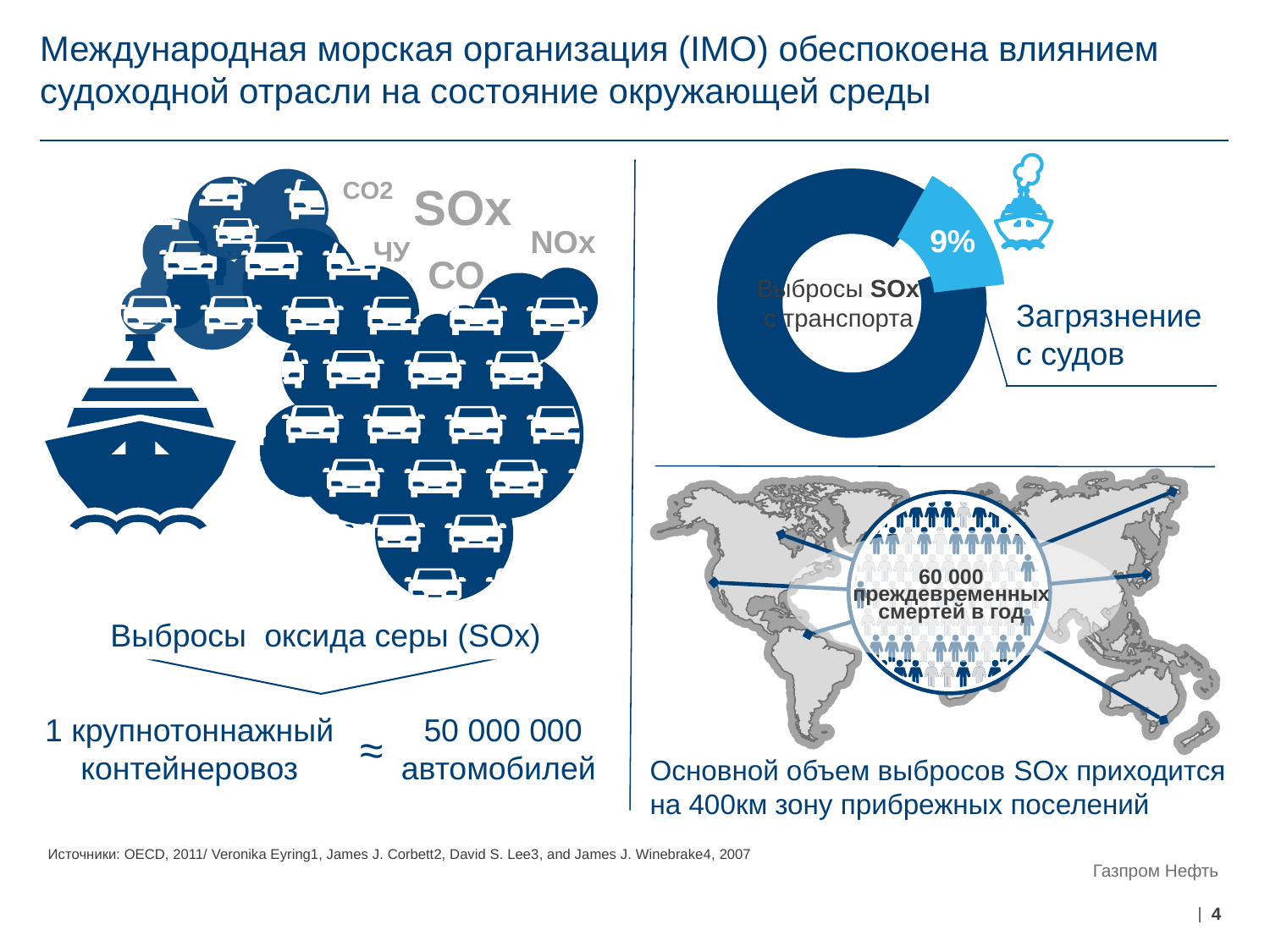
In the donut chart, what share of transport SOx emissions is attributed to ships (Загрязнение с судов)? 9% What colour is the slice labelled 'Загрязнение с судов' in the donut chart? Light blue In the donut chart, which is larger: the slice for ship pollution or the remaining slice? The remaining slice What kind of chart is shown in the upper right of the slide? Pie chart (donut) In the donut chart, what percentage label is printed on the highlighted slice? 9% How many slices does the donut chart have? 2 What is the title written in the centre of the donut chart? Выбросы SOx с транспорта